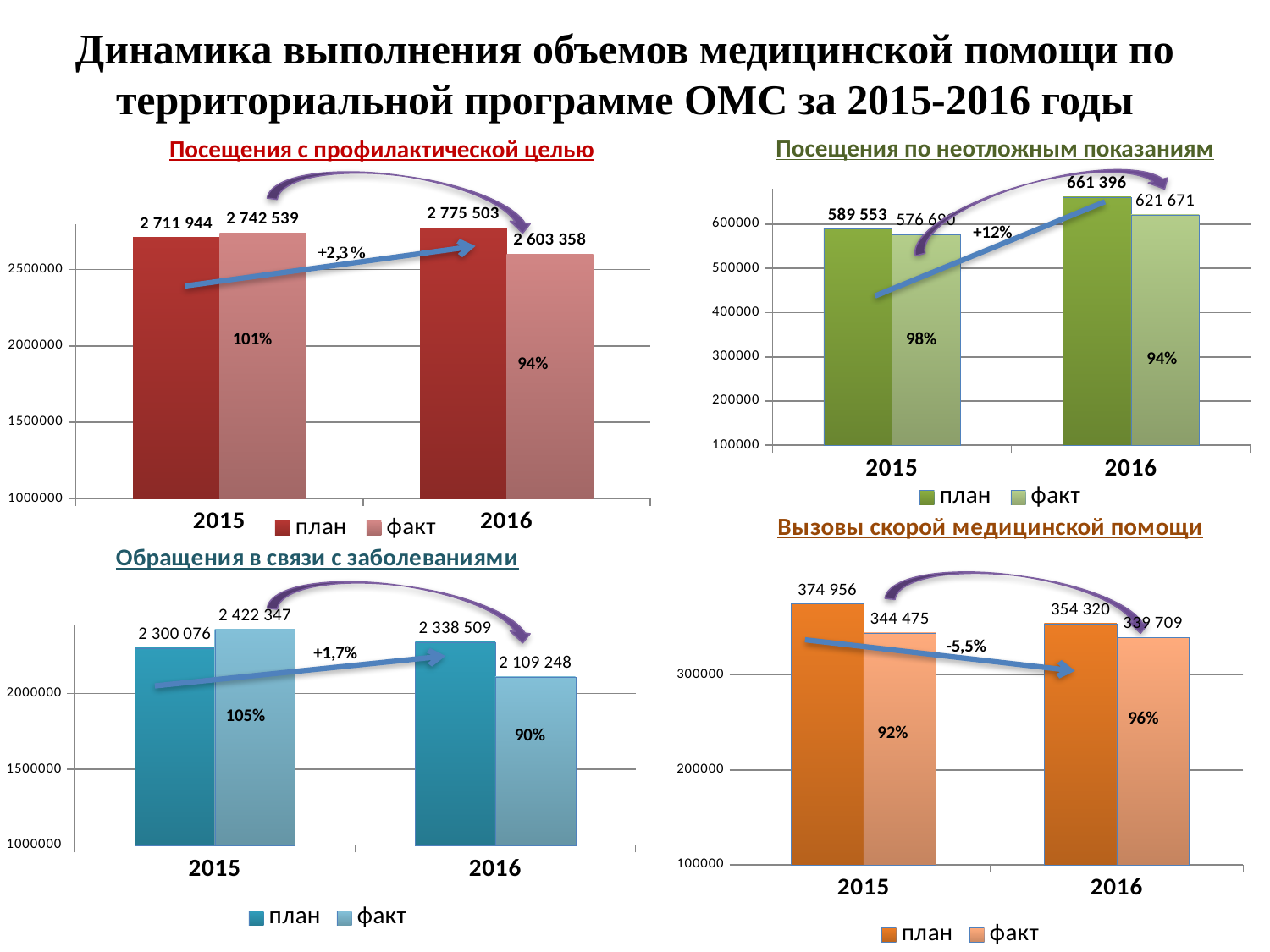
In the chart 'Посещения с профилактической целью', what is the value of план for 2016? 2 775 503 How many series does the legend of the chart 'Вызовы скорой медицинской помощи' list? 2 In the chart 'Вызовы скорой медицинской помощи', what is the value of план for 2015? 374 956 In the chart 'Посещения по неотложным показаниям', is the value of факт for 2016 greater or less than 600000? greater In the chart 'Посещения по неотложным показаниям', which is larger for 2016, план or факт? план In the chart 'Посещения с профилактической целью', what is the difference between план and факт for 2016? 172 145 In the chart 'Обращения в связи с заболеваниями', which bar is the highest? факт 2015 In the chart 'Посещения с профилактической целью', what is the value of факт for 2015? 2 742 539 In the chart 'Обращения в связи с заболеваниями', what is the value of факт for 2016? 2 109 248 In the chart 'Обращения в связи с заболеваниями', what is the difference between факт and план for 2015? 122 271 In the chart 'Вызовы скорой медицинской помощи', which bar is the lowest? факт 2016 In the chart 'Посещения по неотложным показаниям', what is the value of план for 2016? 661 396